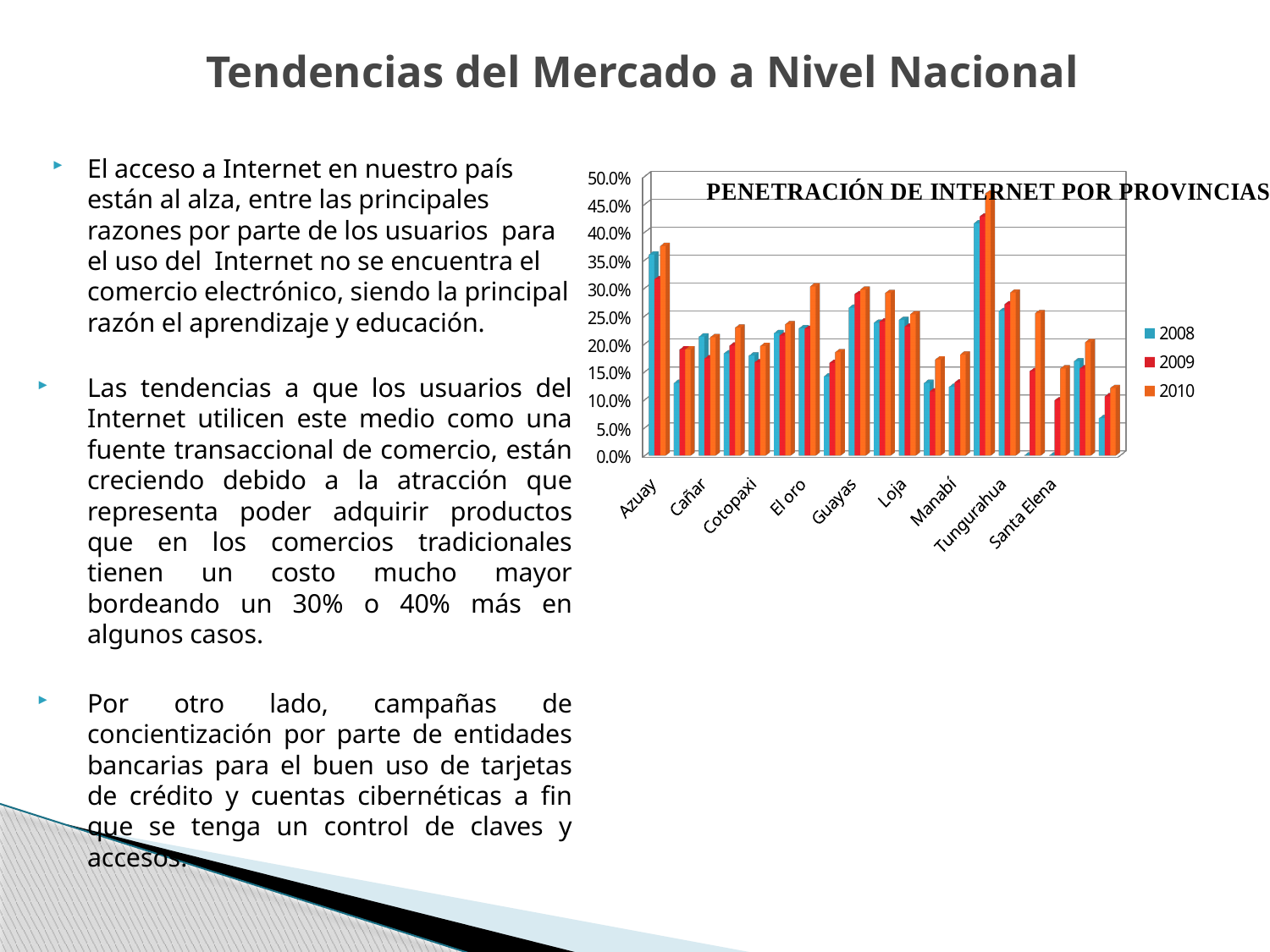
What is the title of the chart? PENETRACIÓN DE INTERNET POR PROVINCIAS Which years are listed in the chart's legend? 2008, 2009, 2010 For Azuay, which year has the lowest value? 2009 How many series does the chart's legend list? 3 Is the 2008 value for Manabí greater or less than 15.0%? less For Guayas, do the values rise or fall from 2008 to 2010? rise What kind of chart is shown on the slide? bar chart Is the 2010 value for Loja greater or less than 20.0%? greater Is the 2008 value for Azuay greater or less than 30.0%? greater Which is larger, the 2008 value for Azuay or the 2008 value for Cotopaxi? Azuay